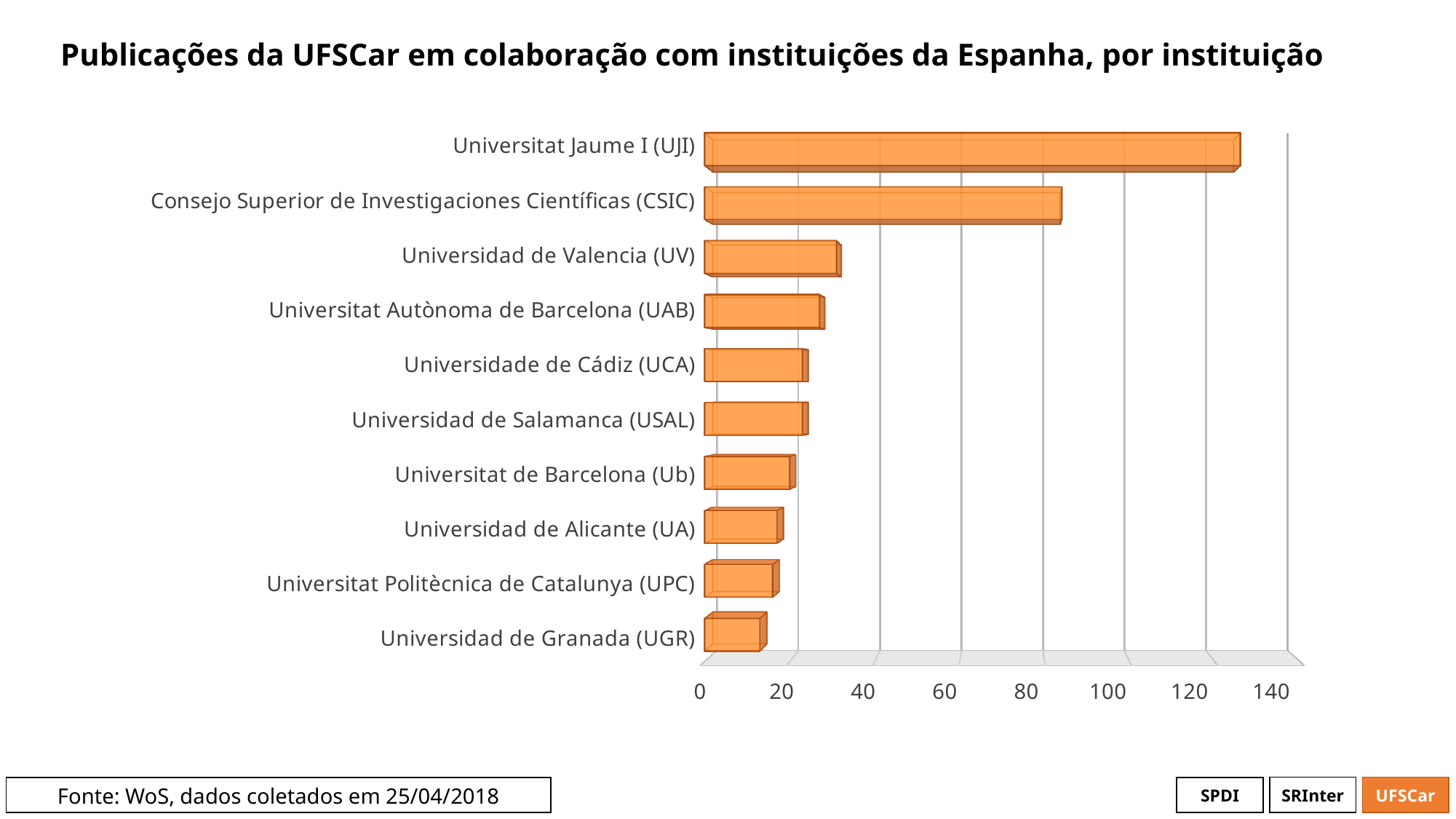
Is the value for Universitat Jaume I (UJI) greater or less than 120? greater Which institution has the highest number of publications in collaboration with UFSCar? Universitat Jaume I (UJI) Is the value for Universidad de Granada (UGR) greater or less than 20? less Is the value for Universitat Autònoma de Barcelona (UAB) greater or less than 40? less What is the title of the chart? Publicações da UFSCar em colaboração com instituições da Espanha, por instituição What kind of chart is shown on the slide? bar chart Which has more publications: Universidad de Valencia (UV) or Universitat Politècnica de Catalunya (UPC)? Universidad de Valencia (UV) Which has more publications: Universitat Jaume I (UJI) or Consejo Superior de Investigaciones Científicas (CSIC)? Universitat Jaume I (UJI) Which institution has the lowest number of publications in collaboration with UFSCar? Universidad de Granada (UGR) How many institutions are shown in the chart? 10